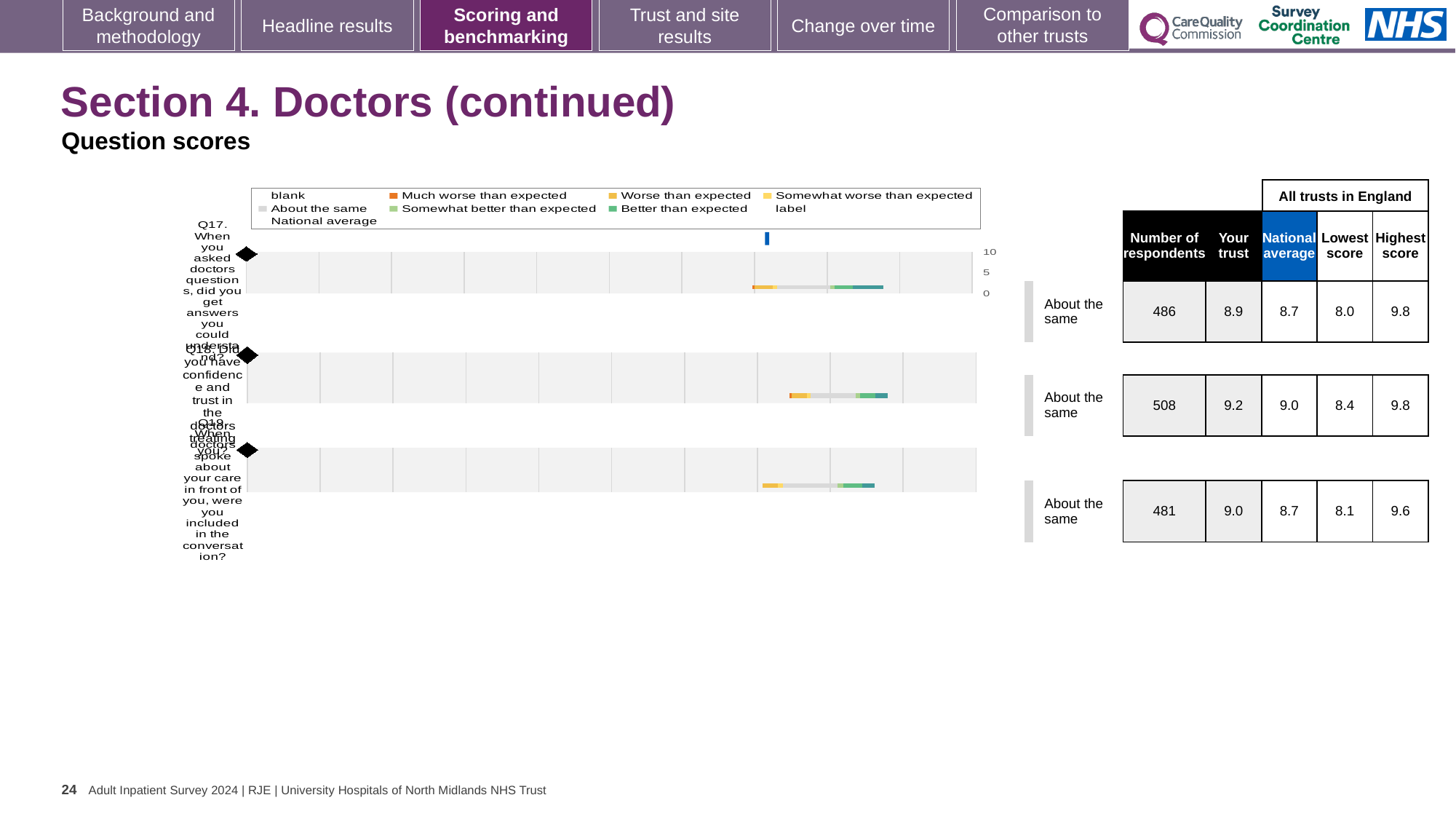
What is the maximum value shown on the chart's score axis? 10 What is the highest score among all trusts in England shown for Q19? 9.6 What is the 'Your trust' score shown for Q18? 9.2 How many questions are plotted in the question scores chart? 3 What is the national average score shown for Q17? 8.7 What benchmark category is shown next to each of the three questions in the chart? About the same How many respondents are shown for Q19? 481 For Q17, which is larger: the 'Your trust' score or the national average? Your trust Is the trust's score marker for Q17 greater or less than 5 on the chart axis? greater Which question has the highest 'Your trust' score? Q18 What kind of chart is used to show the question scores for Q17, Q18 and Q19? bar chart What is the difference between the 'Your trust' score and the national average for Q18? 0.2